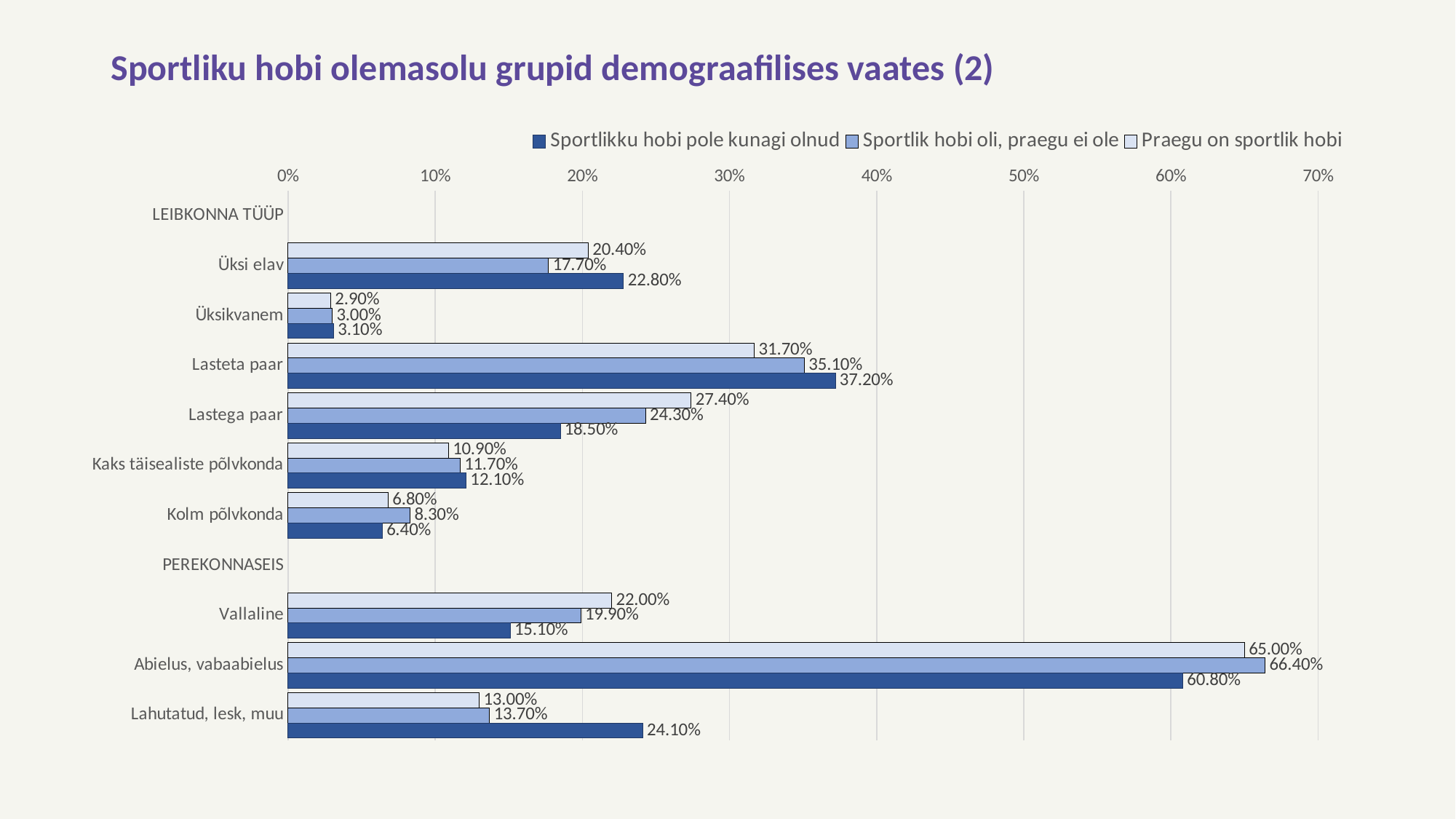
What is the value for "Lastega paar" in the "Sportlikku hobi pole kunagi olnud" series? 18.50% What is the value for "Vallaline" in the "Praegu on sportlik hobi" series? 22.00% How many series does the legend list? 3 Which category has the highest value in the "Praegu on sportlik hobi" series? Abielus, vabaabielus What is the difference between the "Sportlikku hobi pole kunagi olnud" and "Praegu on sportlik hobi" values for "Lahutatud, lesk, muu"? 11.10% What kind of chart is shown on the slide? Bar chart What is the value for "Abielus, vabaabielus" in the "Sportlik hobi oli, praegu ei ole" series? 66.40% Is the "Sportlikku hobi pole kunagi olnud" value for "Abielus, vabaabielus" greater or less than 50%? greater Which category has the lowest value in the "Sportlikku hobi pole kunagi olnud" series? Üksikvanem For "Lasteta paar", which is larger: the "Sportlikku hobi pole kunagi olnud" value or the "Praegu on sportlik hobi" value? Sportlikku hobi pole kunagi olnud How many categories are listed under the "LEIBKONNA TÜÜP" group? 6 What is the title of the slide? Sportliku hobi olemasolu grupid demograafilises vaates (2)